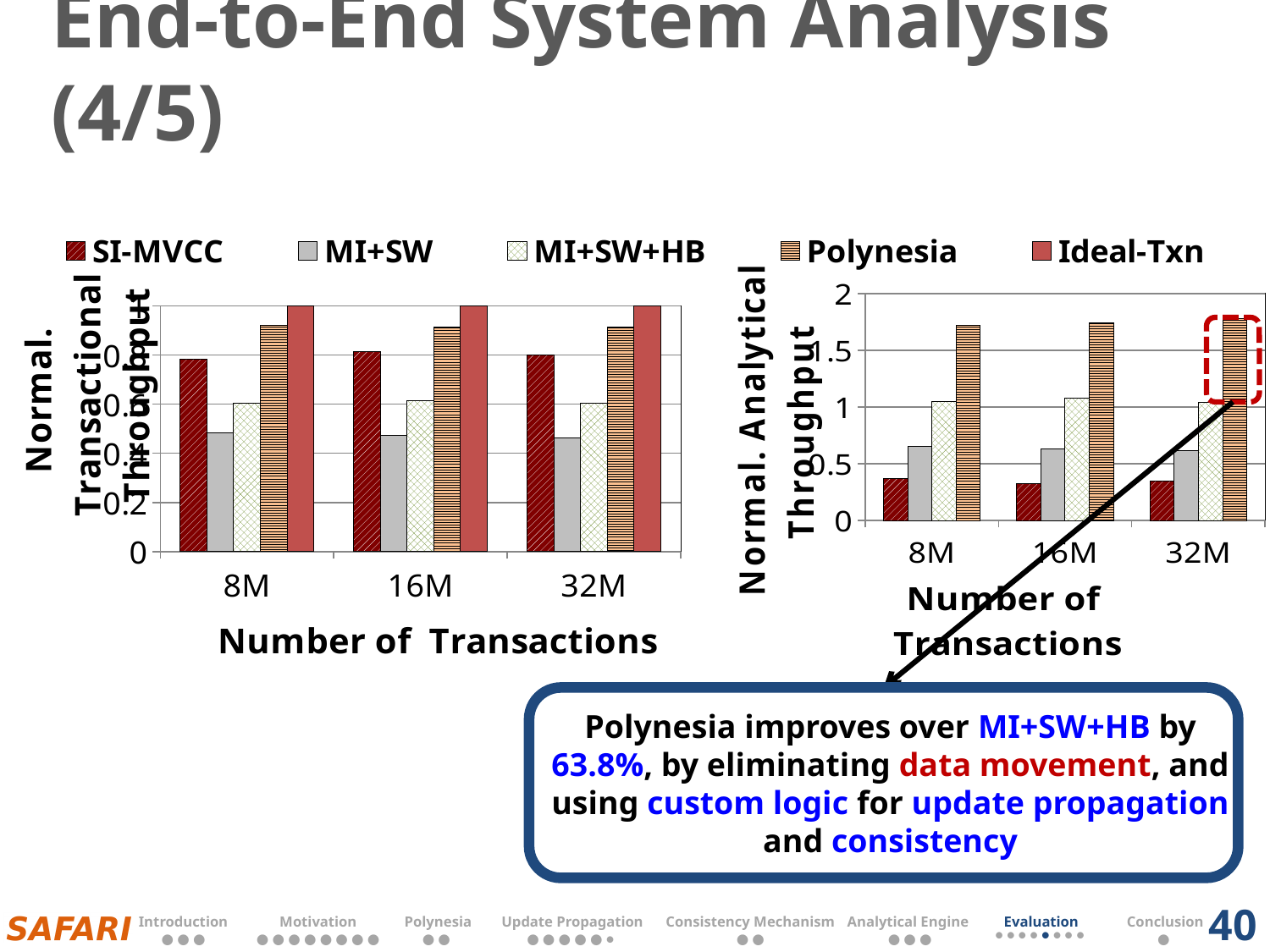
In the Normal. Analytical Throughput chart on the right, is the value for MI+SW at 8M greater or less than 0.5? greater What is the x-axis title of the Normal. Transactional Throughput chart on the left? Number of Transactions How many categories are shown on the x axis of the Normal. Analytical Throughput chart on the right? 3 What kind of chart is the Normal. Transactional Throughput chart on the left? bar chart In the Normal. Analytical Throughput chart on the right, is the value for Polynesia at 8M greater or less than 1.5? greater In the Normal. Analytical Throughput chart on the right, which series has the highest value at 32M? Polynesia In the Normal. Analytical Throughput chart on the right, which series has the lowest value at 16M? SI-MVCC In the Normal. Transactional Throughput chart on the left, which series has the lowest value at 32M? MI+SW In the Normal. Transactional Throughput chart on the left, which is larger at 16M: SI-MVCC or MI+SW? SI-MVCC In the Normal. Transactional Throughput chart on the left, which series has the highest value at 8M? Ideal-Txn In the Normal. Analytical Throughput chart on the right, is the value for SI-MVCC at 8M greater or less than 0.5? less How many series does the legend at the top of the slide list? 5